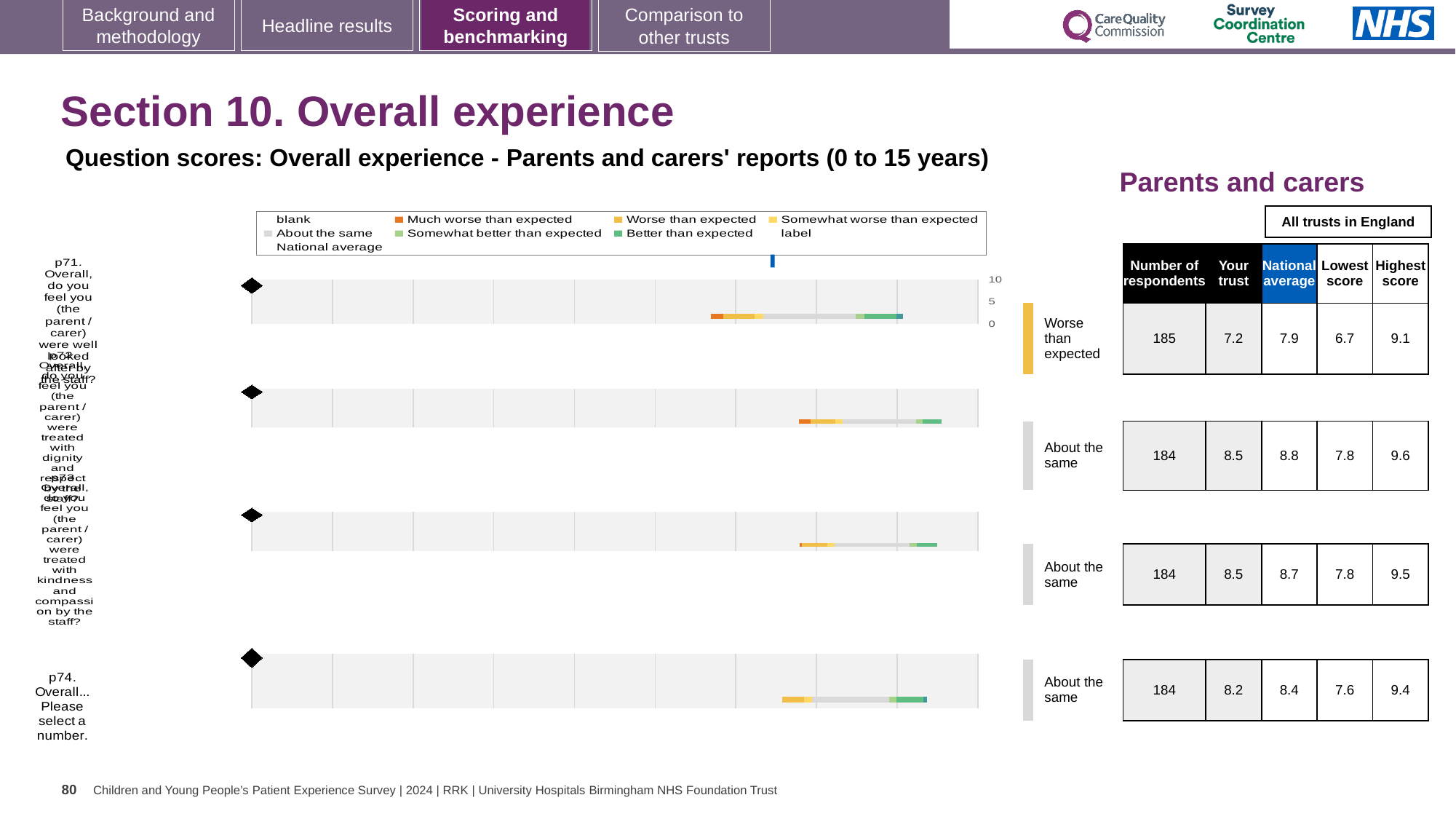
What kind of chart is used to show the question scores on this slide? bar chart Which question has the lowest 'Your trust' score? p71 What is the national average score for question p74 (Overall... Please select a number)? 8.4 What is the highest score across all trusts in England for question p72? 9.6 How many respondents answered question p71? 185 Which has the higher 'Your trust' score, question p72 or question p74? p72 What is the difference between the national average and the 'Your trust' score for question p71? 0.7 What is the 'Your trust' score for question p71 (were you well looked after by the staff)? 7.2 What is the lowest score across all trusts in England for question p74? 7.6 What benchmark category is shown for question p71? Worse than expected How many questions (bars) are plotted in the chart? 4 In the chart legend, what colour represents 'Much worse than expected'? orange